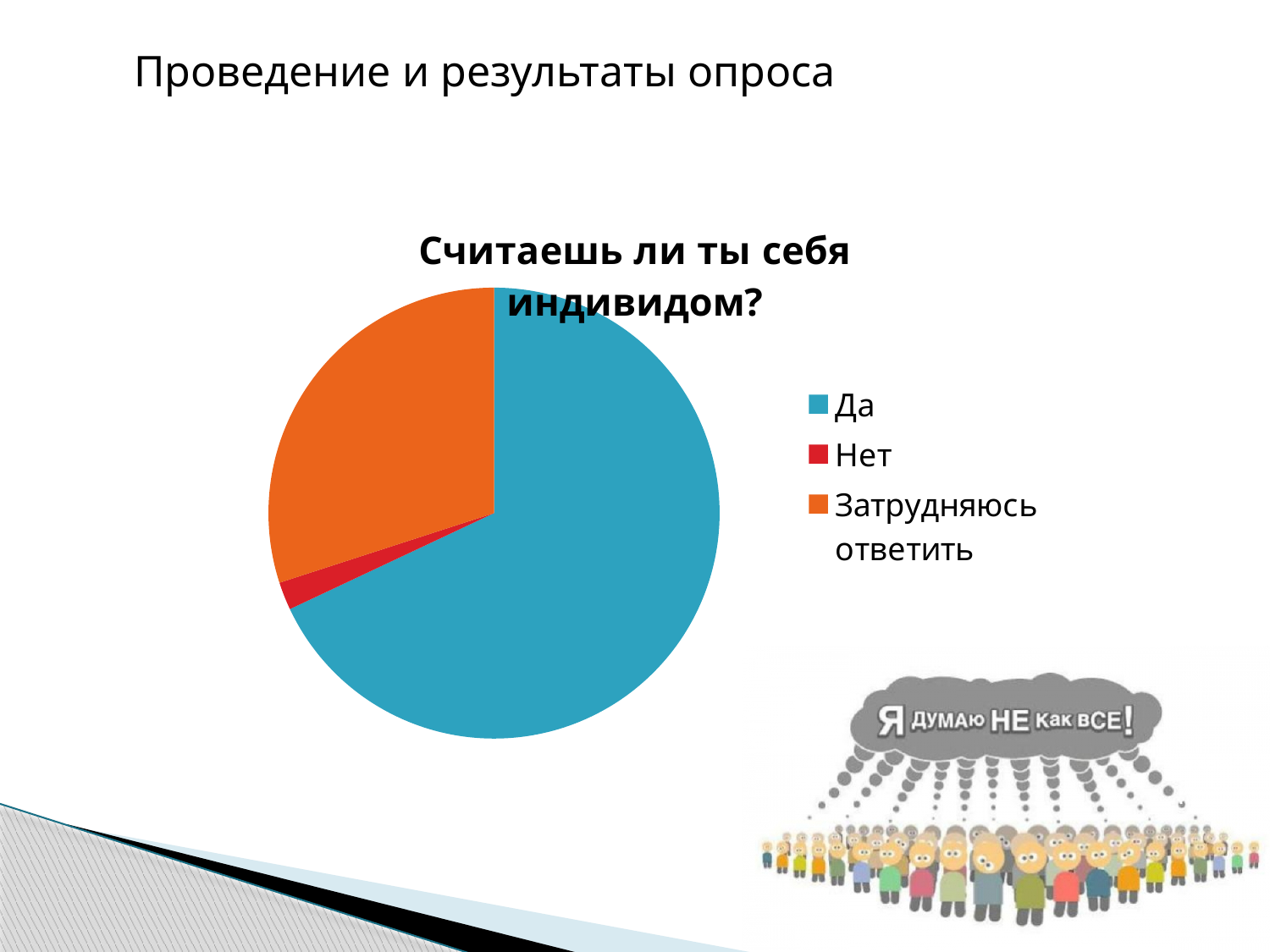
How many entries does the legend list? 3 Which answer option has the smallest slice of the pie? Нет What is the title of the pie chart? Считаешь ли ты себя индивидом? Which colour represents "Нет" in the pie chart? red Which slice is larger, "Нет" or "Затрудняюсь ответить"? Затрудняюсь ответить Which slice is larger, "Да" or "Затрудняюсь ответить"? Да What kind of chart is shown on the slide? pie chart Which answer option has the largest slice of the pie? Да How many slices does the pie chart have? 3